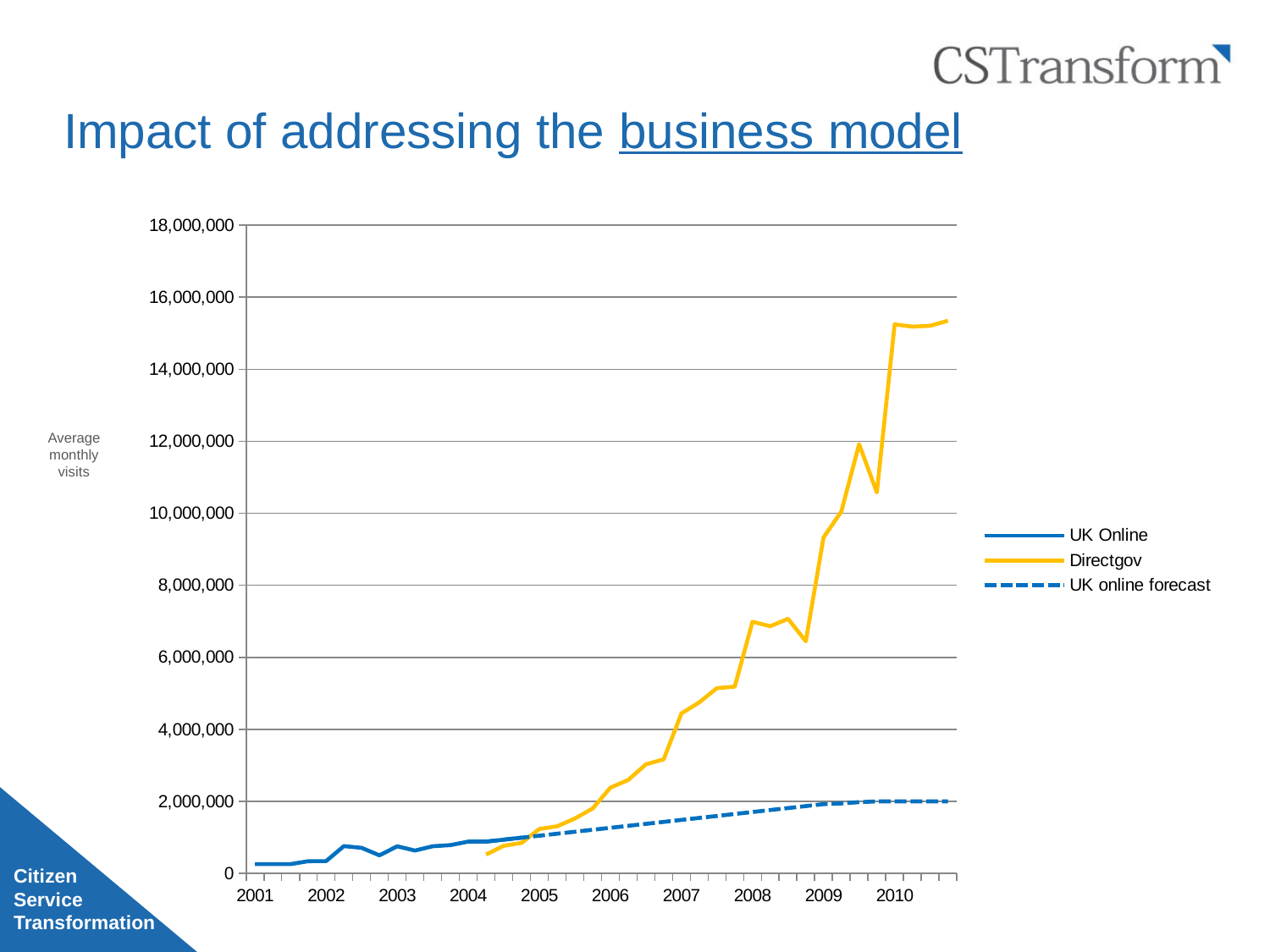
How many series does the legend list? 3 Is the value for Directgov in 2010 greater or less than 14,000,000? greater What is the first year shown on the x axis? 2001 In 2010, which series has the higher value, Directgov or UK online forecast? Directgov Is the value for UK Online in 2001 greater or less than 2,000,000? less Does the Directgov line rise or fall from 2005 to 2010? Rise Which series is drawn with a dashed line? UK online forecast Which series reaches the highest value on the chart? Directgov Is the value for Directgov in 2008 greater or less than 10,000,000? less What is the label on the vertical axis of the chart? Average monthly visits What kind of chart is shown on the slide? Line chart